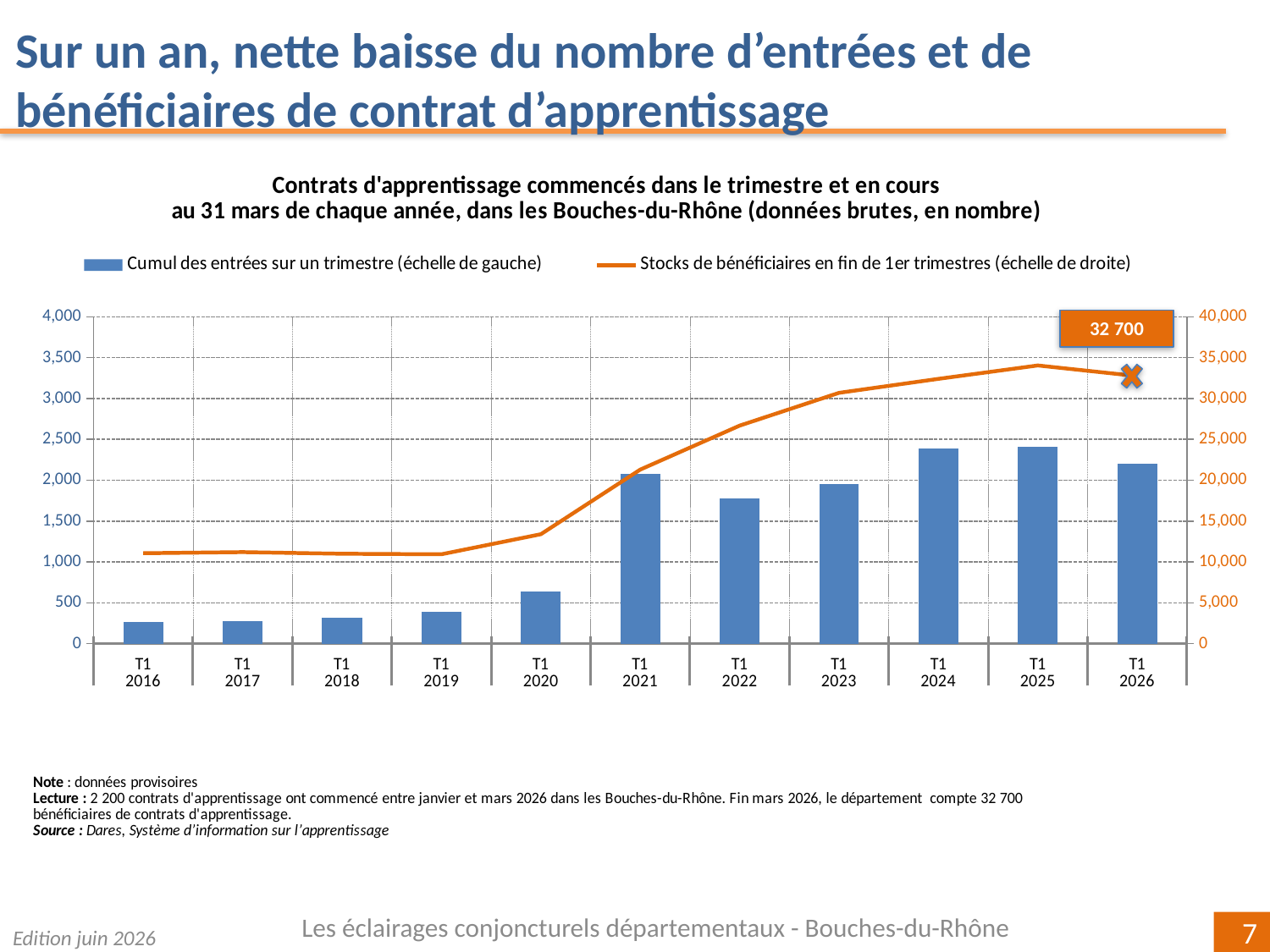
Is the bar value for T1 2020 (Cumul des entrées) greater or less than 500? greater Which colour is used for the line showing stocks of beneficiaries? Orange What is the value of the stock of beneficiaries (Stocks de bénéficiaires) at T1 2026, as shown by the data label? 32 700 Is the bar value for T1 2022 (Cumul des entrées) greater or less than 2,000? less In which quarter does the line for stocks of beneficiaries reach its highest point? T1 2025 How many quarters (categories) are shown on the x axis? 11 Does the line for stocks of beneficiaries rise or fall between T1 2019 and T1 2025? It rises How many series does the legend list? 2 What kind of chart is shown on the slide? A combination bar and line chart Which bar is taller: T1 2026 or T1 2022? T1 2026 Is the stock of beneficiaries at T1 2016 greater or less than 10,000 on the right-hand axis? greater According to the reading note on the slide, how many apprenticeship contracts started between January and March 2026 in the Bouches-du-Rhône? 2 200